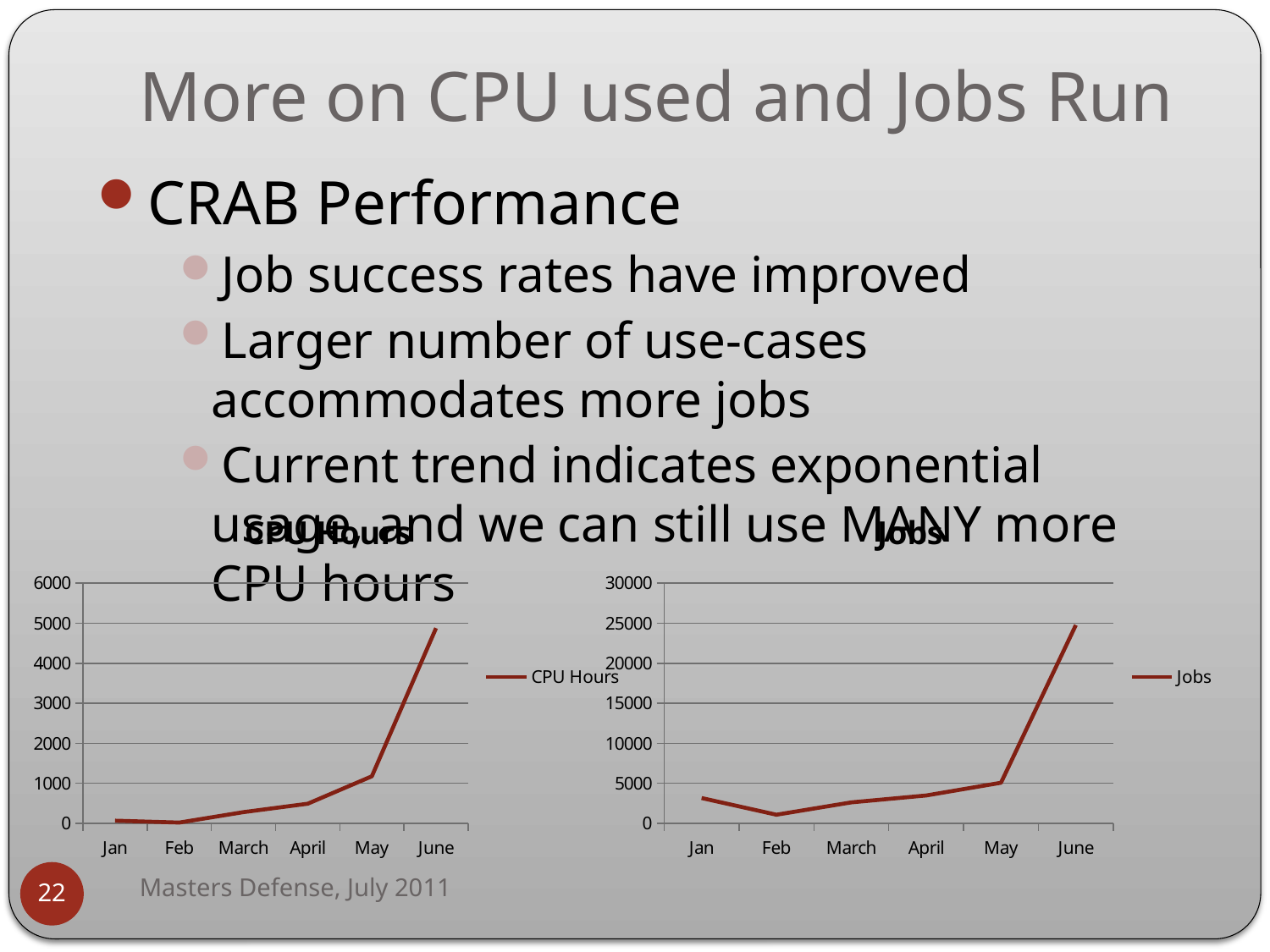
In the "Jobs" chart, is the value for June greater or less than 20000? greater In the "Jobs" chart, do the values rise or fall from March to June? rise In the "CPU Hours" chart, is the value for May greater or less than 2000? less In the "CPU Hours" chart, is the value for June greater or less than 4000? greater In the "CPU Hours" chart, which is larger, the value for April or the value for May? May In the "Jobs" chart, which month has the highest value? June What kind of chart is the left chart titled "CPU Hours"? line chart In the "CPU Hours" chart, which month has the highest value? June In the "Jobs" chart, which month has the lowest value? Feb In the "CPU Hours" chart, how many months are shown on the x axis? 6 What is the title of the right chart? Jobs How many series does the legend of the "Jobs" chart list? 1